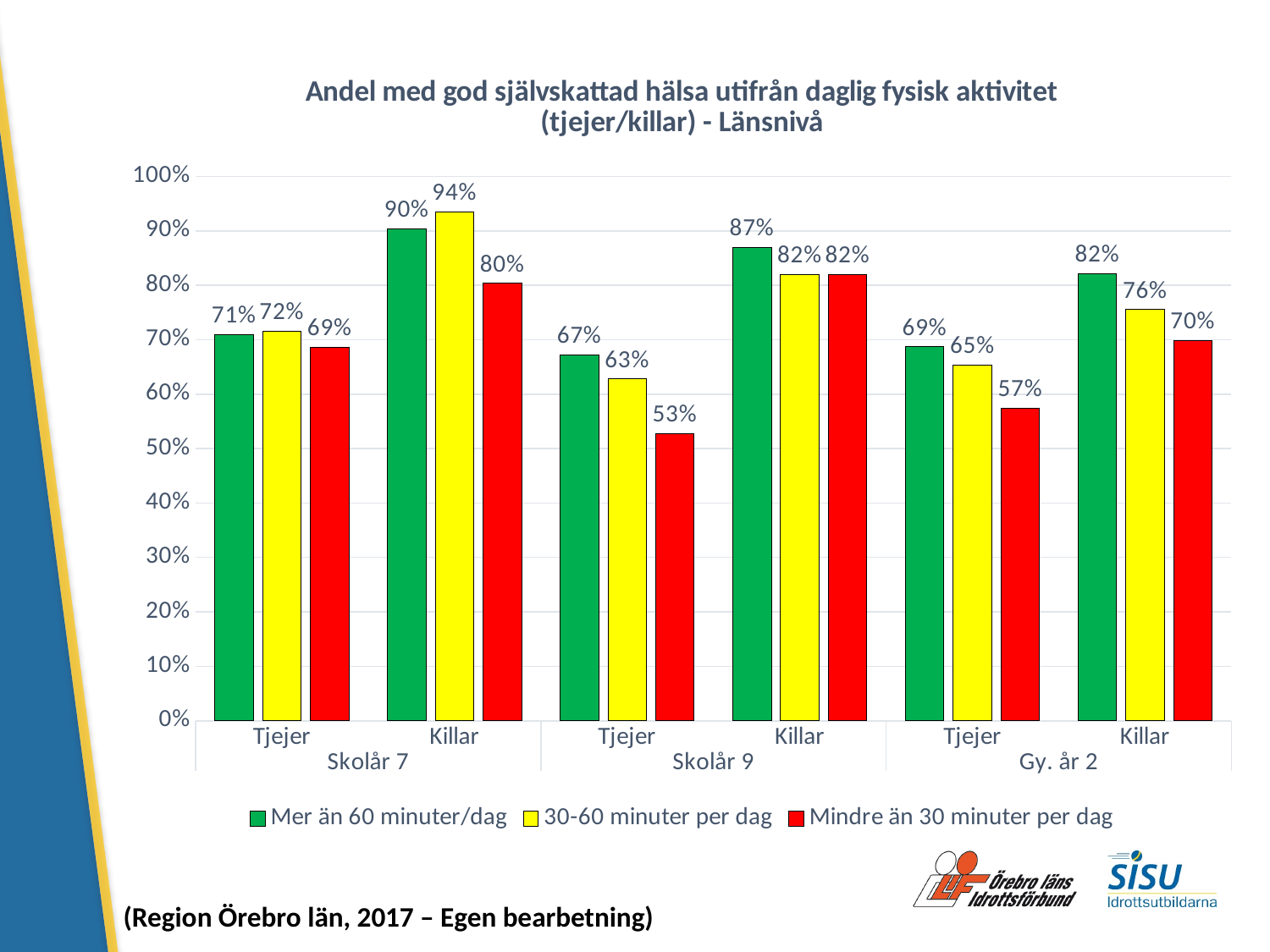
Which colour represents 'Mindre än 30 minuter per dag' in the legend? Red What is the value for 'Mer än 60 minuter/dag' among Killar in Skolår 7? 90% Is the value for 'Mindre än 30 minuter per dag' among Killar in Skolår 9 greater or less than 80%? greater Which group has the highest value for '30-60 minuter per dag'? Killar, Skolår 7 What is the value for 'Mindre än 30 minuter per dag' among Tjejer in Skolår 9? 53% Which group has the lowest value for 'Mindre än 30 minuter per dag'? Tjejer, Skolår 9 What is the value for '30-60 minuter per dag' among Killar in Gy. år 2? 76% How many series does the legend list? 3 What is the difference between 'Mer än 60 minuter/dag' and 'Mindre än 30 minuter per dag' for Tjejer in Skolår 9? 14 percentage points What kind of chart is shown on the slide? Bar chart How many groups (category bars clusters) are shown on the x axis? 6 Which is larger for Tjejer in Gy. år 2: 'Mer än 60 minuter/dag' or '30-60 minuter per dag'? Mer än 60 minuter/dag